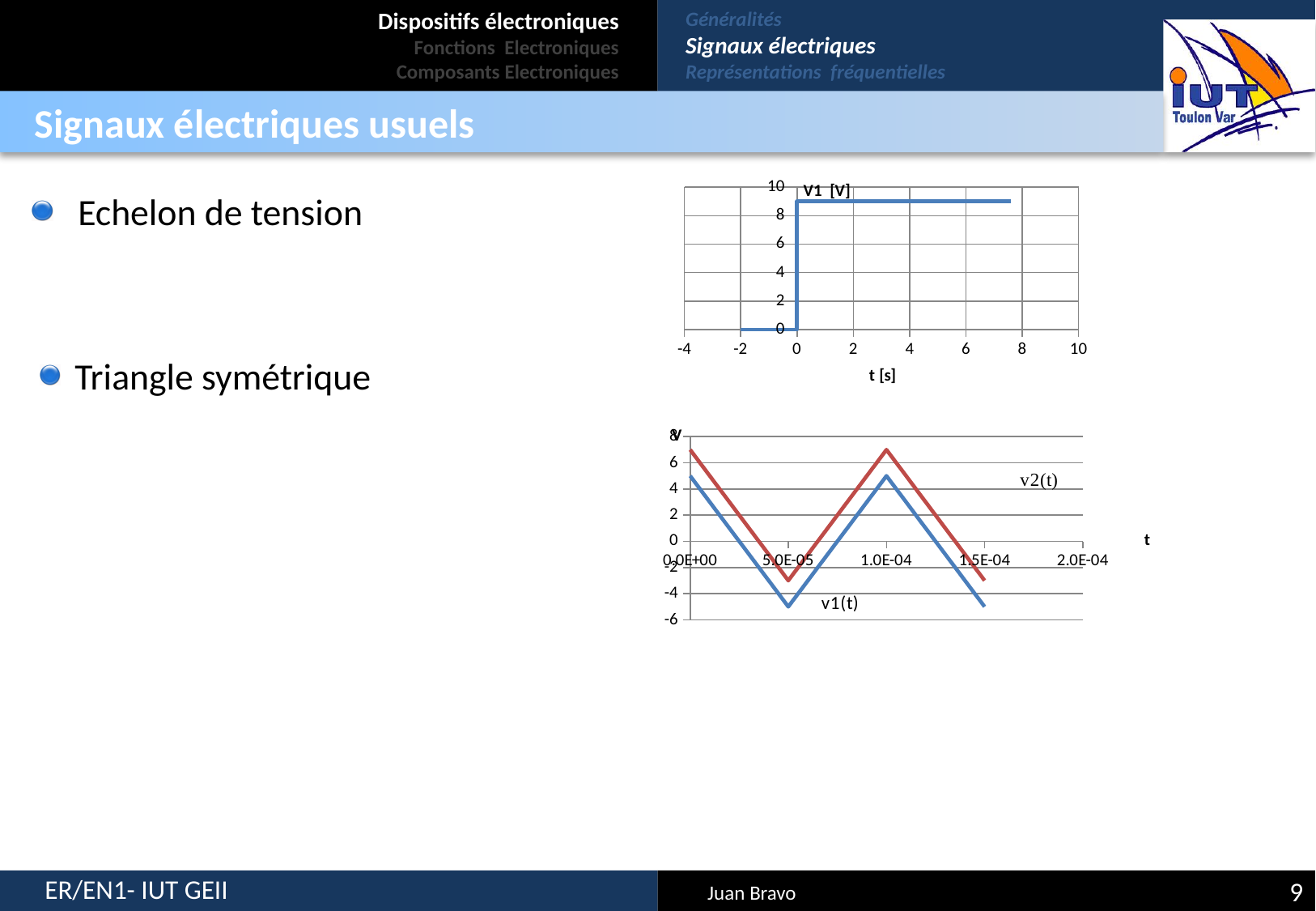
In the top chart V1 [V], at what value of t does the signal step up? 0 In the bottom chart, which signal reaches the lower minimum value, v1(t) or v2(t)? v1(t) In the bottom chart, which signal reaches the higher peak value, v1(t) or v2(t)? v2(t) What kind of chart is the top chart titled V1 [V]? line chart In the top chart V1 [V], is the value of V1 for t greater than 0 greater or less than 10? less How many signals are plotted in the bottom chart? 2 What kind of chart is the bottom chart showing v1(t) and v2(t)? line chart In the top chart V1 [V], what is the label of the horizontal axis? t [s] In the top chart V1 [V], is the value of V1 for t greater than 0 greater or less than 8? greater In the top chart V1 [V], what is the value of V1 for t less than 0? 0 In the bottom chart, does v1(t) rise or fall between t = 0.0E+00 and t = 5.0E-05? fall In the bottom chart, is the peak value of v2(t) greater or less than 6? greater